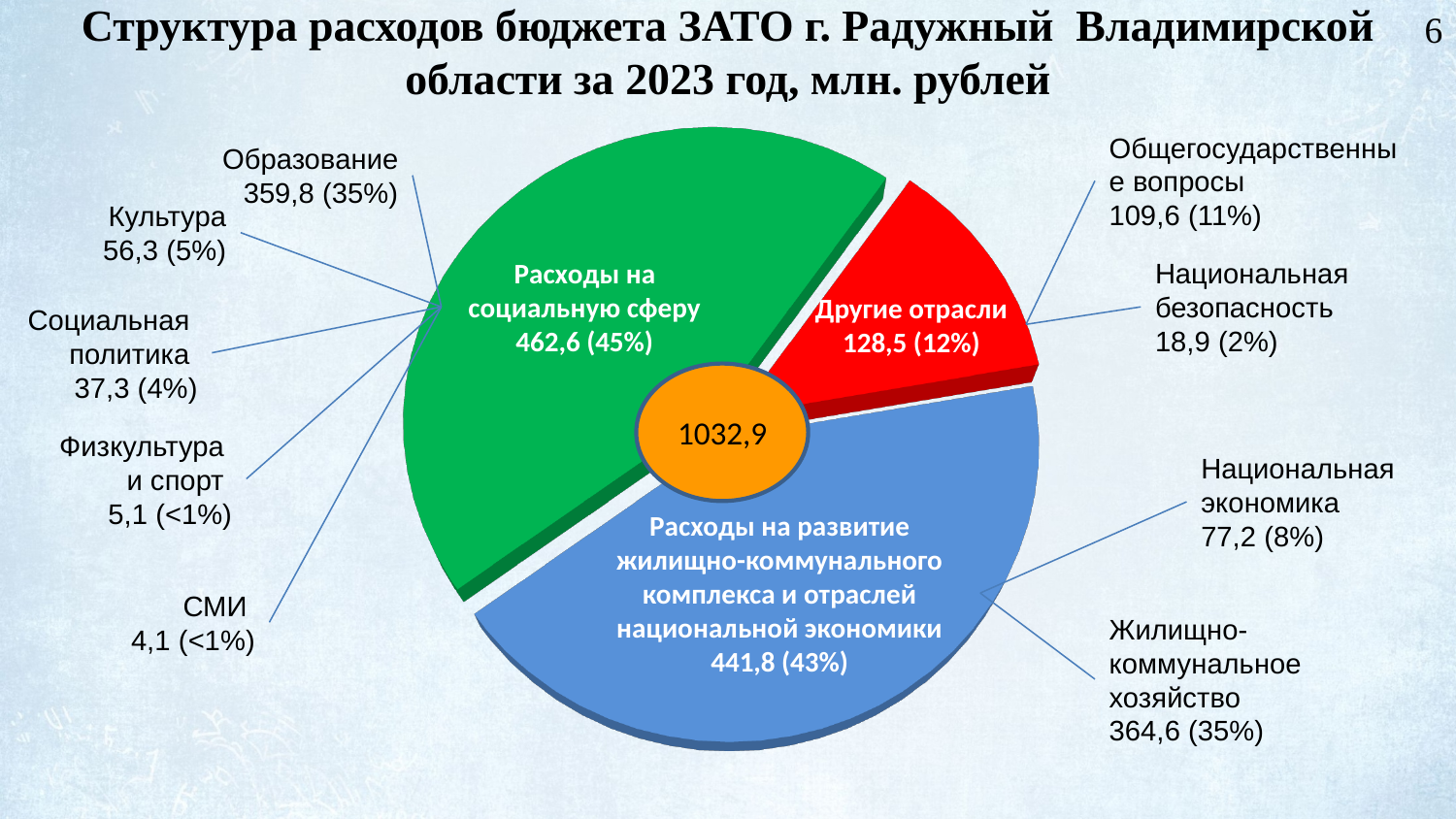
На сколько млн. рублей расходы на социальную сферу больше расходов на развитие жилищно-коммунального комплекса и отраслей национальной экономики? 20,8 Какое значение указано для сектора «Расходы на развитие жилищно-коммунального комплекса и отраслей национальной экономики»? 441,8 (43%) Какое общее значение расходов указано в центре диаграммы? 1032,9 Каким цветом показан сектор «Другие отрасли»? Красным Какое значение указано для сектора «Расходы на социальную сферу»? 462,6 (45%) Какой сектор диаграммы самый маленький? Другие отрасли Какой тип диаграммы показан на слайде? Круговая диаграмма Сколько секторов содержит круговая диаграмма? 3 Что больше: расходы на социальную сферу или расходы на другие отрасли? Расходы на социальную сферу Какой сектор диаграммы самый большой? Расходы на социальную сферу Какое значение указано для сектора «Другие отрасли»? 128,5 (12%) Какая доля расходов приходится на сектор «Другие отрасли»? 12%